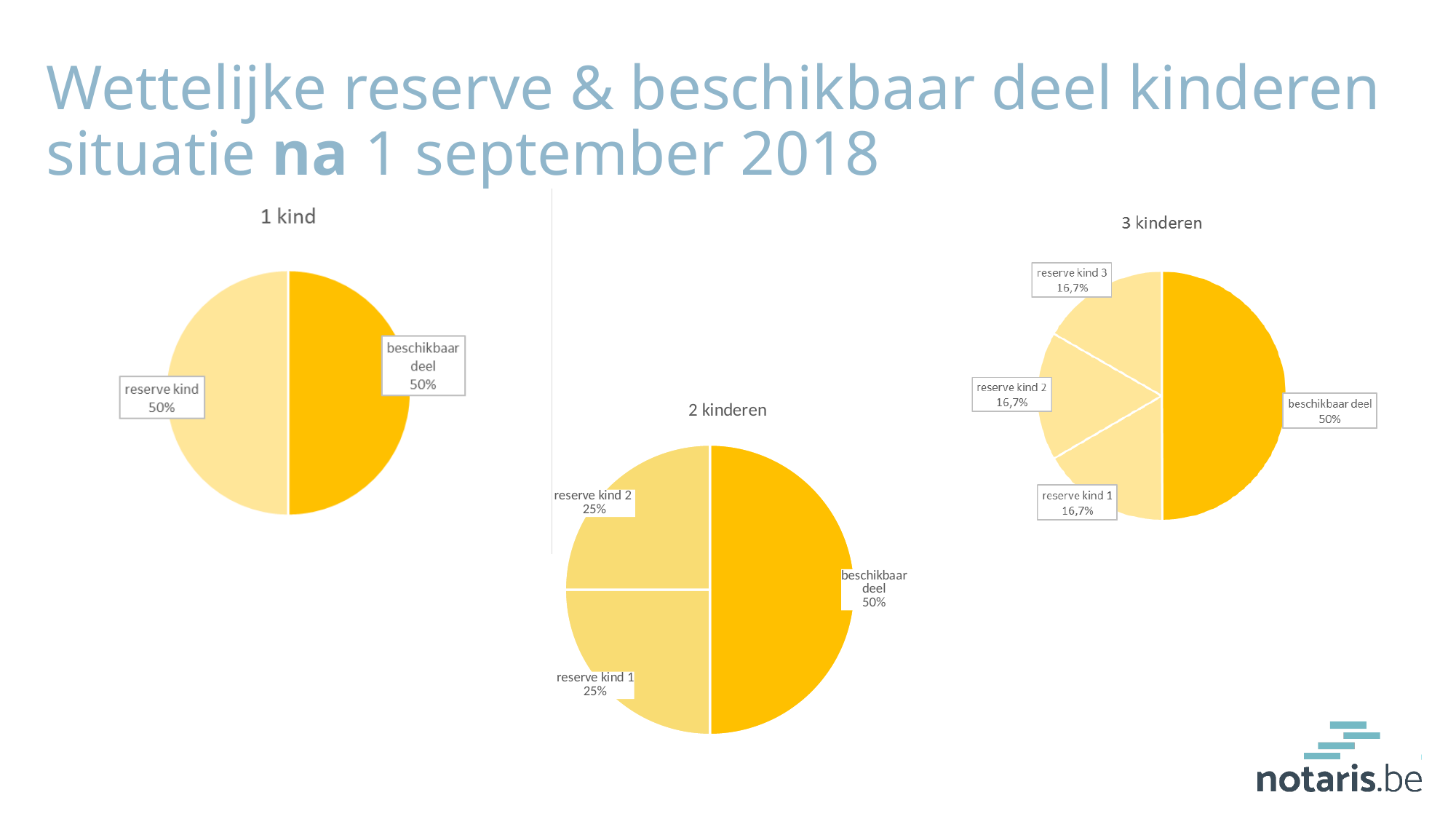
How many charts are shown on the slide? 3 How many slices does the '2 kinderen' chart have? 3 In the '1 kind' chart, what share does 'beschikbaar deel' have? 50% In the '2 kinderen' chart, what share does 'beschikbaar deel' have? 50% In the '2 kinderen' chart, what share does 'reserve kind 1' have? 25% In the '2 kinderen' chart, which is larger: 'beschikbaar deel' or 'reserve kind 2'? beschikbaar deel In the '3 kinderen' chart, which slice is the largest? beschikbaar deel How many slices does the '3 kinderen' chart have? 4 What type of chart is the '1 kind' chart? pie chart In the '3 kinderen' chart, what share does 'reserve kind 3' have? 16,7% In the '1 kind' chart, what share does 'reserve kind' have? 50% In the '2 kinderen' chart, what is the difference between 'beschikbaar deel' and 'reserve kind 1'? 25%